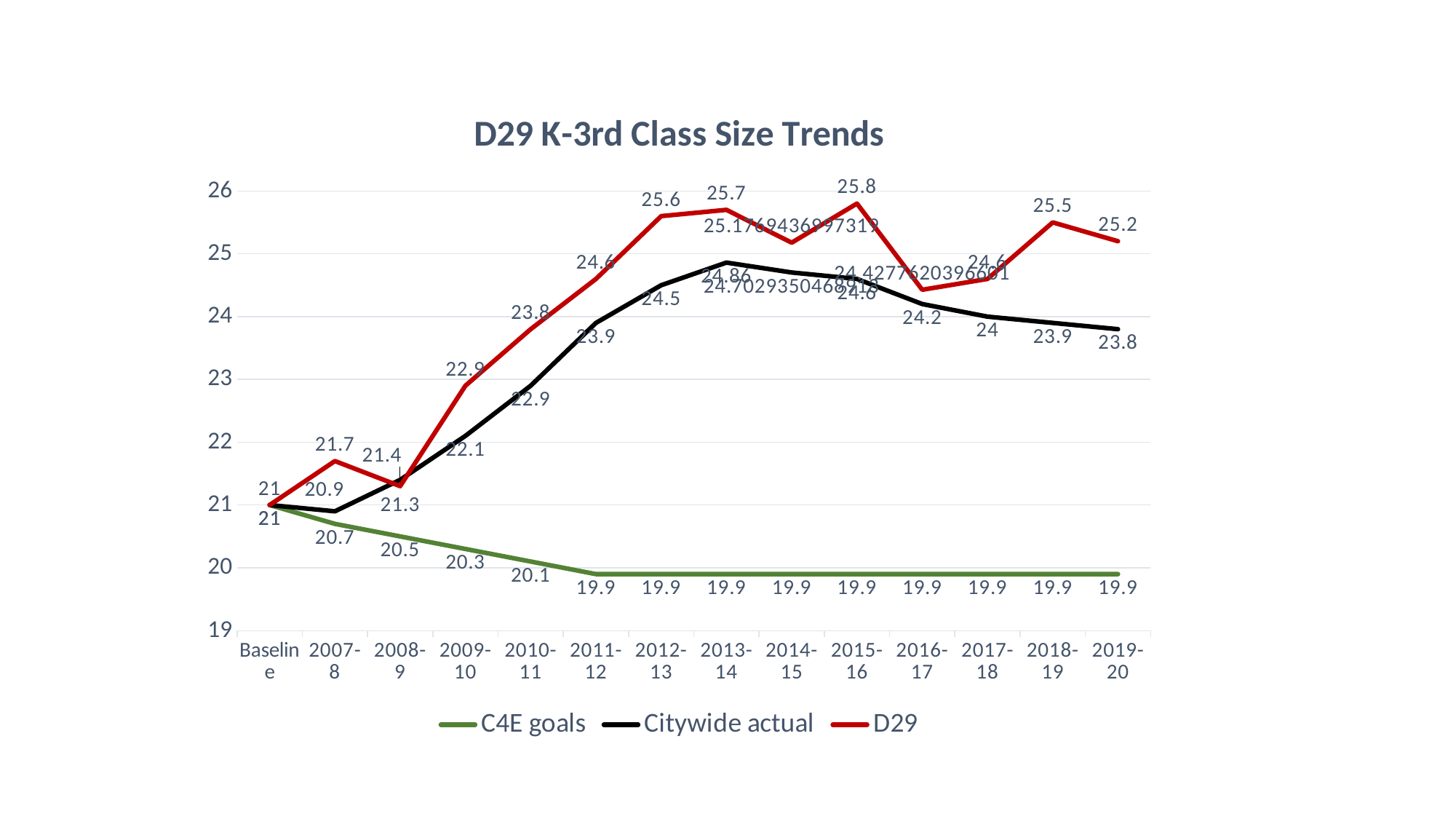
What is the C4E goals value for 2010-11? 20.1 In which year does the D29 series reach its highest value? 2015-16 How many series does the legend list? 3 What is the D29 value for 2012-13? 25.6 What kind of chart is shown on the slide? line chart How many categories are shown along the x axis? 14 What is the Citywide actual value for 2013-14? 24.86 What is the difference between the D29 and Citywide actual values in 2019-20? 1.4 Which is larger in 2007-8, the D29 value or the Citywide actual value? D29 What is the Citywide actual value for 2019-20? 23.8 Do the C4E goals values rise or fall from Baseline to 2011-12? fall What colour is the D29 line in the legend? red